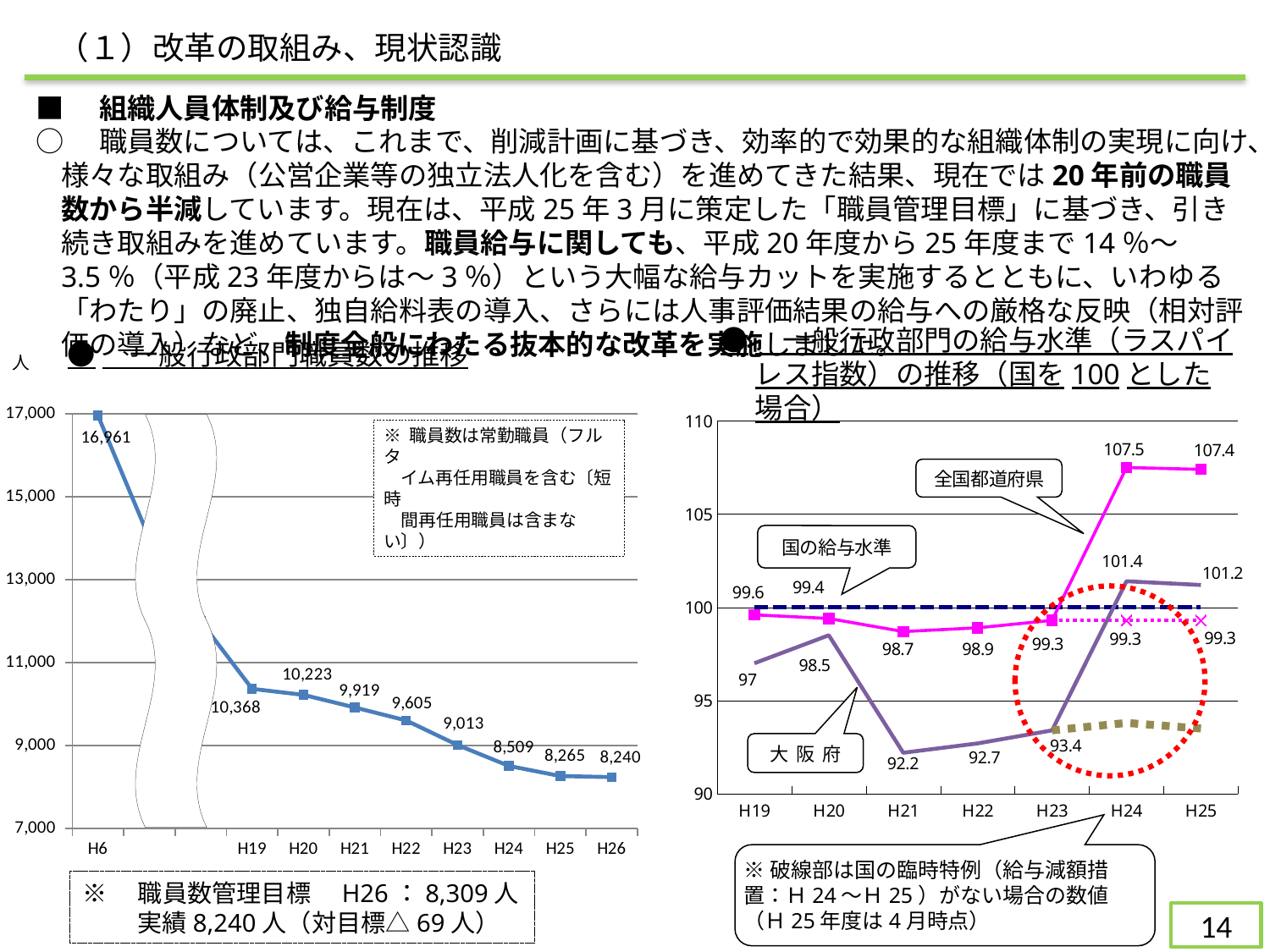
In the left chart (一般行政部門職員数の推移), which year has the lowest value? H26 In the right chart (ラスパイレス指数の推移), what is the value for 全国都道府県 in H24? 107.5 In the left chart (一般行政部門職員数の推移), what is the value for H6? 16,961 In the left chart (一般行政部門職員数の推移), do the values rise or fall from H19 to H26? fall In the left chart (一般行政部門職員数の推移), how many years are plotted on the x axis? 9 What kind of chart is the right chart (ラスパイレス指数の推移)? line chart In the right chart (ラスパイレス指数の推移), which is larger in H23: 全国都道府県 or 大阪府? 全国都道府県 In the right chart (ラスパイレス指数の推移), what is the difference between 全国都道府県 and 大阪府 in H25? 6.2 In the right chart (ラスパイレス指数の推移), what is the value for 大阪府 in H21? 92.2 In the left chart (一般行政部門職員数の推移), what is the value for H26? 8,240 In the left chart (一般行政部門職員数の推移), what is the value for H22? 9,605 In the left chart (一般行政部門職員数の推移), what is the difference between the H19 value and the H20 value? 145